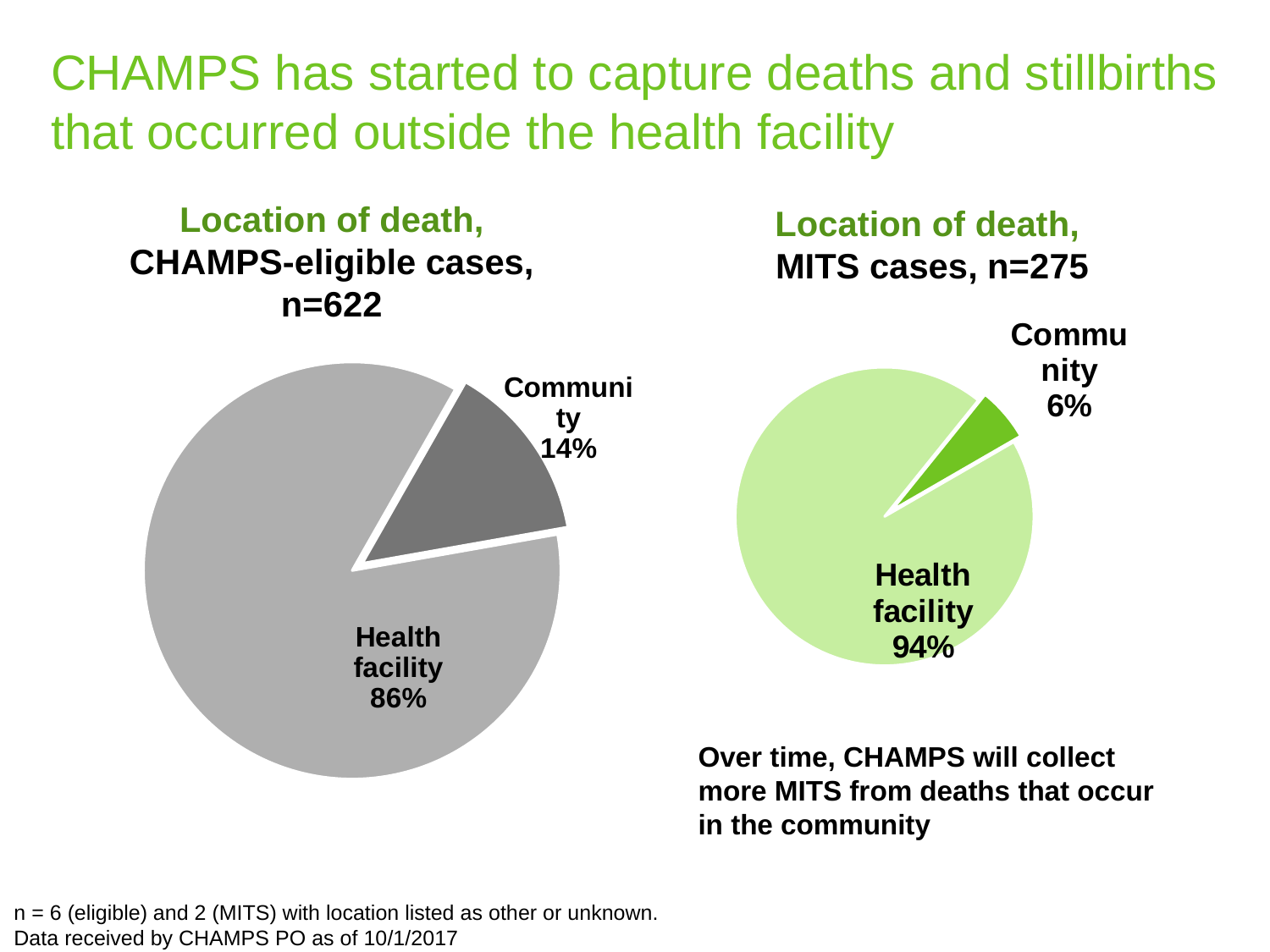
How many slices does the 'Location of death, CHAMPS-eligible cases, n=622' pie chart have? 2 In the 'Location of death, MITS cases, n=275' chart, what share of cases occurred in the community? 6% In the 'Location of death, CHAMPS-eligible cases, n=622' chart, which location has the largest share? Health facility In the 'Location of death, MITS cases, n=275' chart, which location has the smallest share? Community In the 'Location of death, CHAMPS-eligible cases, n=622' chart, what share of cases occurred in the community? 14% What type of chart is used for 'Location of death, MITS cases, n=275'? Pie chart What is the sample size stated in the title of the right-hand chart? n=275 In the 'Location of death, CHAMPS-eligible cases, n=622' chart, what share of cases occurred in a health facility? 86% In the 'Location of death, MITS cases, n=275' chart, what share of cases occurred in a health facility? 94% How many charts are shown on the slide? 2 Which chart shows a larger community share: the CHAMPS-eligible cases chart or the MITS cases chart? CHAMPS-eligible cases In the 'Location of death, CHAMPS-eligible cases, n=622' chart, what is the difference in percentage points between the health facility and community shares? 72